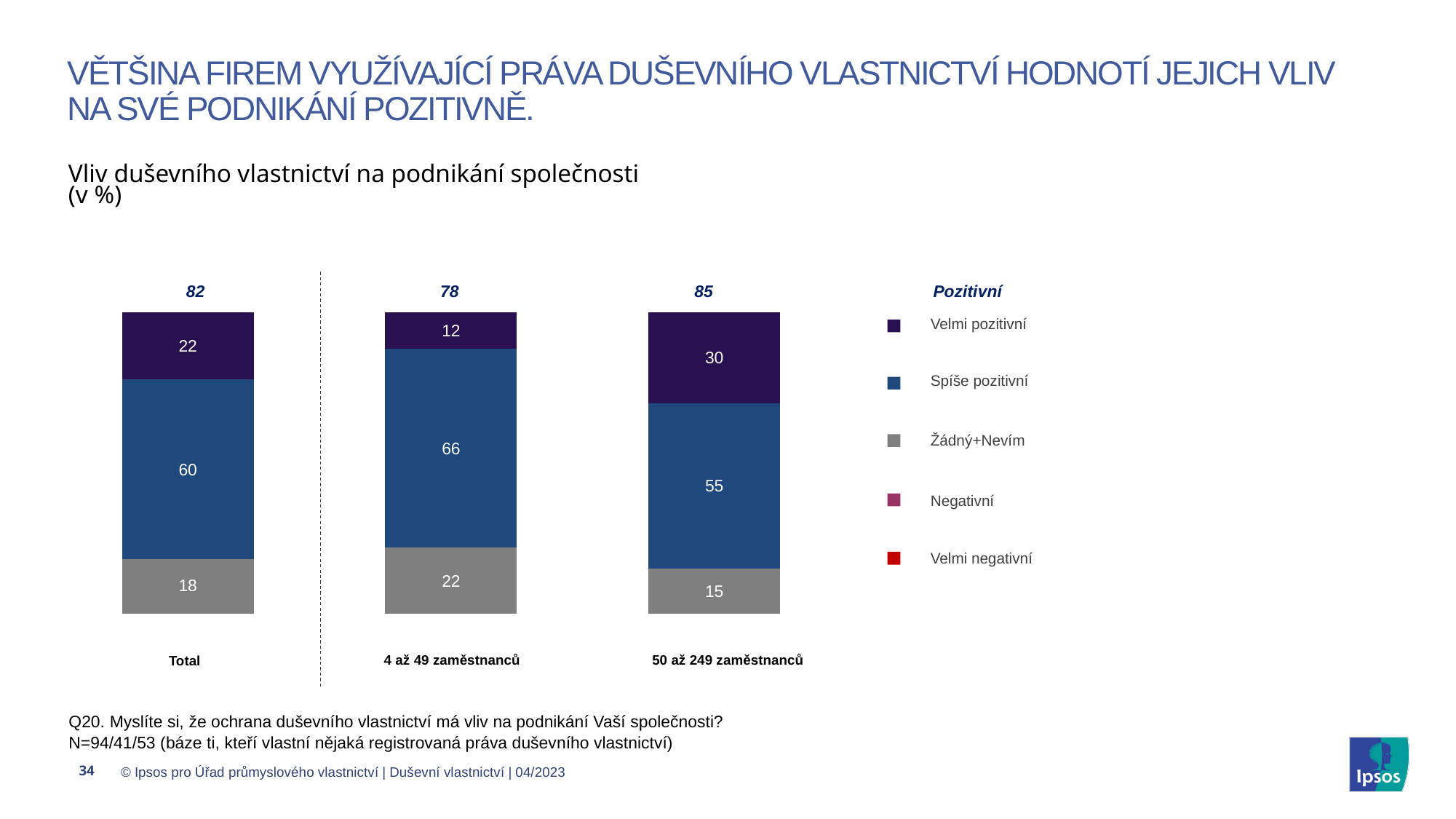
Which category has the lowest value for Velmi pozitivní? 4 až 49 zaměstnanců What is the Pozitivní total shown above the 50 až 249 zaměstnanců bar? 85 Which is larger: the Žádný+Nevím value for Total or for 4 až 49 zaměstnanců? 4 až 49 zaměstnanců What is the sum of the Velmi pozitivní and Spíše pozitivní values for the Total bar? 82 What is the value for Velmi pozitivní in the Total bar? 22 How many series does the legend list? 5 What is the value for Spíše pozitivní for 4 až 49 zaměstnanců? 66 How many categories (bars) are shown in the chart? 3 Which category has the highest Pozitivní total? 50 až 249 zaměstnanců What is the value for Žádný+Nevím for 50 až 249 zaměstnanců? 15 What is the difference between the Spíše pozitivní values for 4 až 49 zaměstnanců and 50 až 249 zaměstnanců? 11 What type of chart is shown on the slide? Stacked bar chart